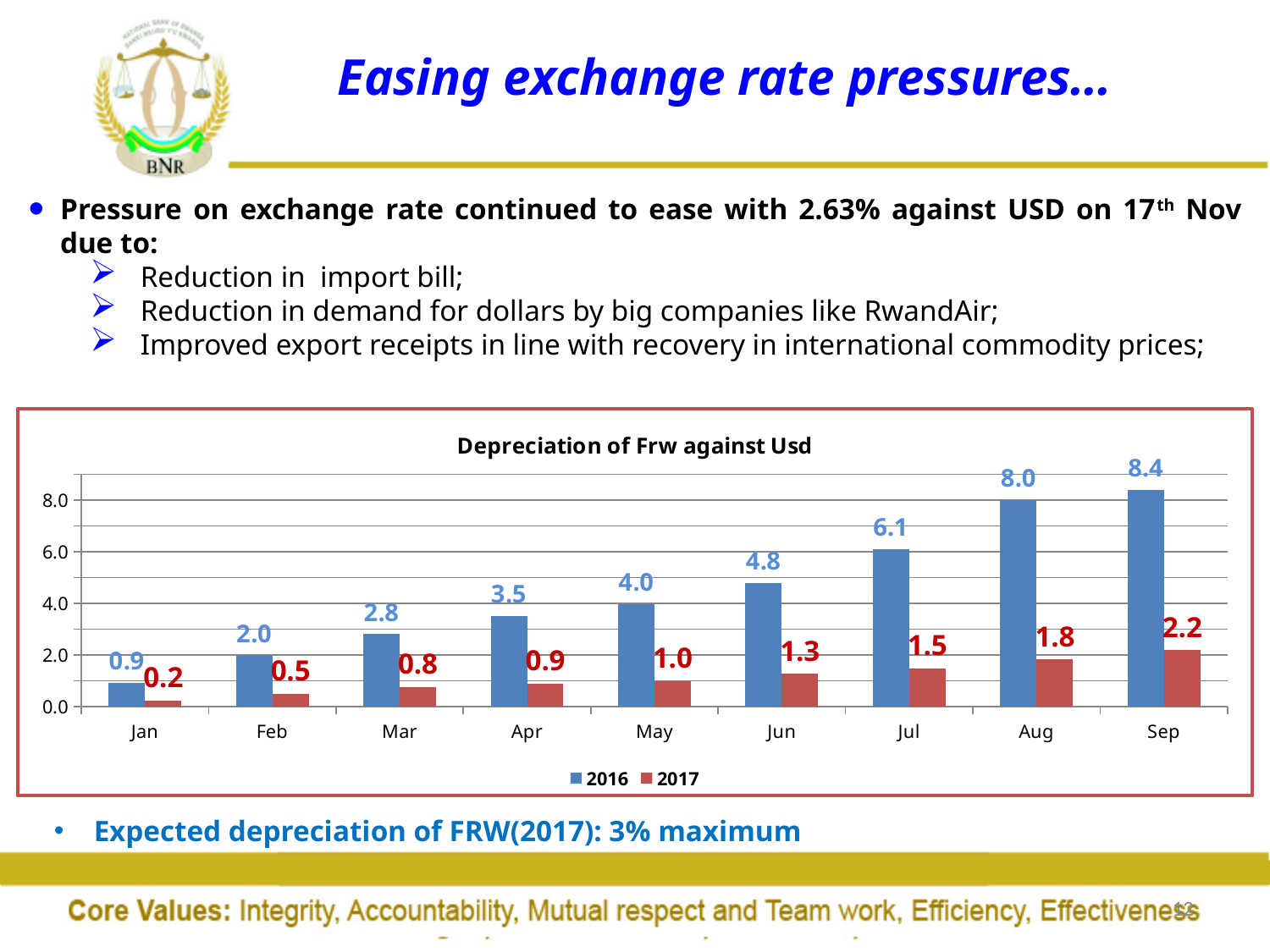
What is the 2016 value for Sep in the Depreciation of Frw against Usd chart? 8.4 Which month has the highest 2017 value? Sep What kind of chart is shown on the slide? Bar chart How many series does the legend list? 2 What is the difference between the 2016 and 2017 values for Aug? 6.2 Which is larger, the 2016 value for Mar or the 2016 value for May? 2016 value for May Is the 2016 value for Jul greater or less than 6.0? greater What is the 2017 value for Jun? 1.3 How many months are shown on the x axis? 9 What is the 2016 value for Apr? 3.5 Which month has the lowest 2016 value? Jan Do the 2016 values rise or fall from Jan to Sep? Rise